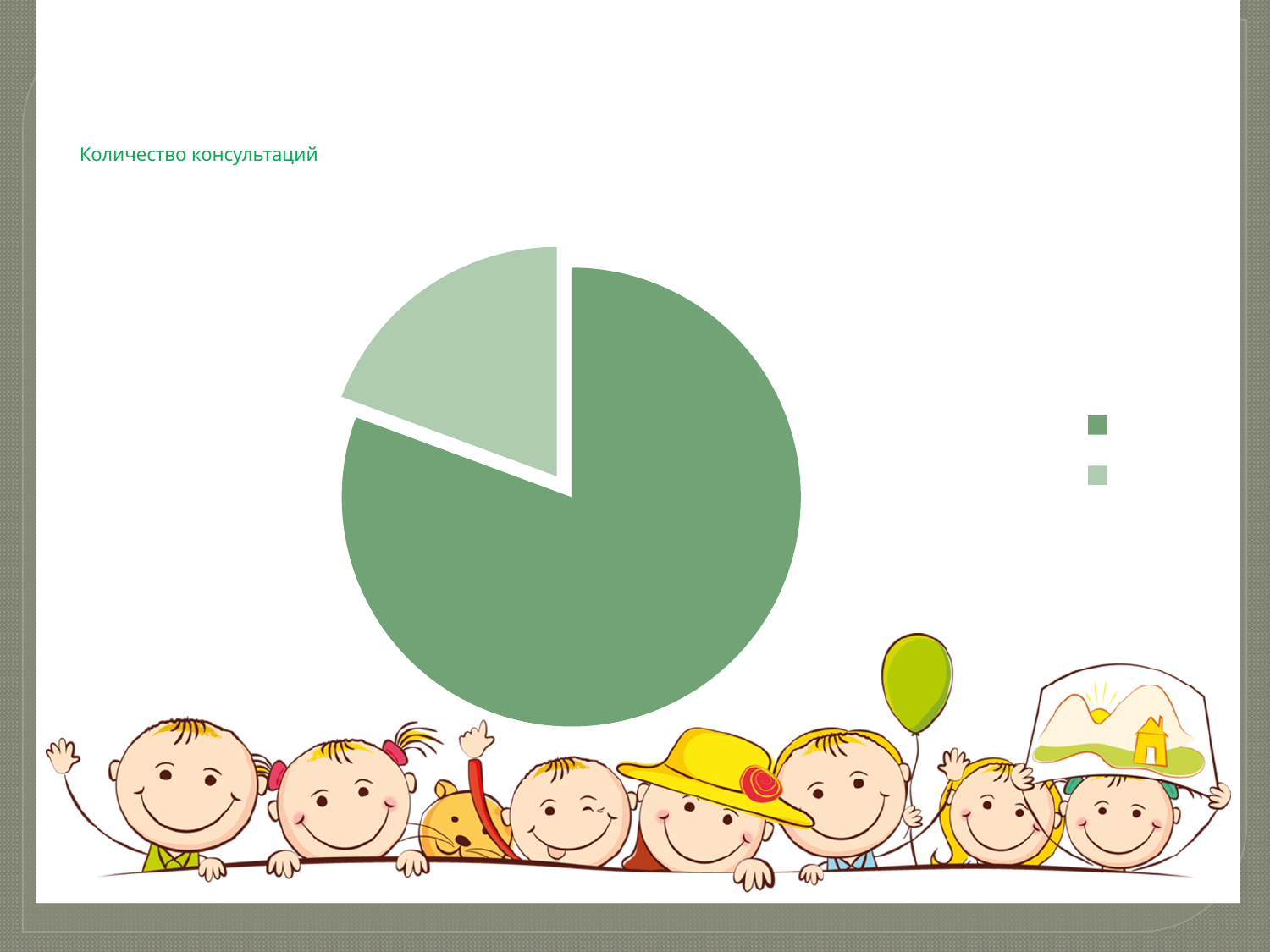
Which slice is pulled out (exploded) from the pie? the light green slice What is the title of the chart? Количество консультаций How many entries does the legend list? 2 What kind of chart is shown on the slide? pie chart Is the dark green slice more or less than half of the pie? more How many slices does the pie chart have? 2 Which colour slice takes up the largest share of the pie? dark green Which colour slice takes up the smallest share of the pie? light green Which slice is larger, the dark green one or the light green one? the dark green one